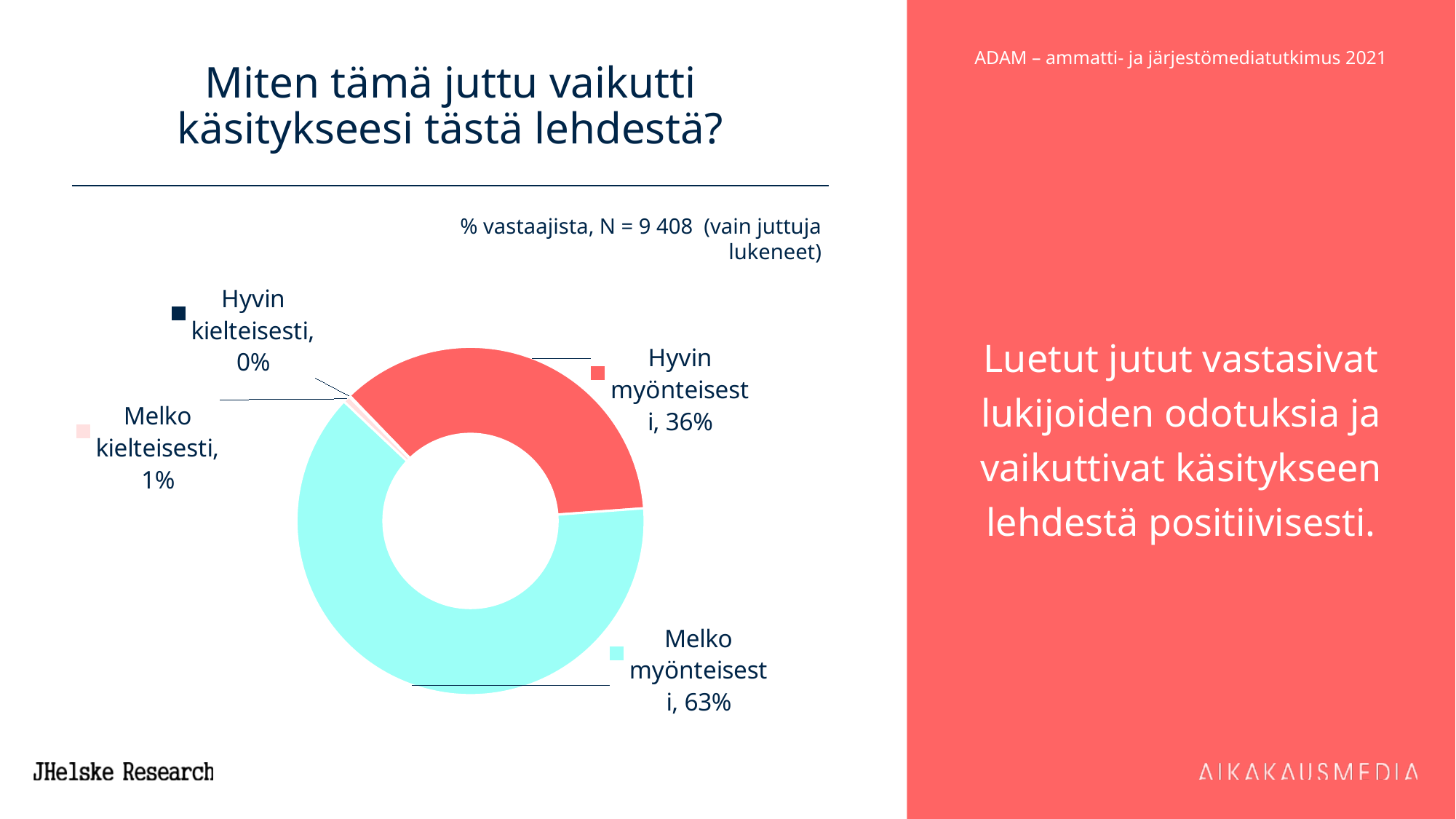
What kind of chart is shown on the slide? Doughnut chart What percentage of respondents answered "Hyvin myönteisesti"? 36% Which category has the smallest share of the chart? Hyvin kielteisesti Which category has the largest share of the chart? Melko myönteisesti What is the number of respondents (N) stated on the slide? 9 408 What is the combined share of the two positive categories ("Hyvin myönteisesti" and "Melko myönteisesti")? 99% What percentage of respondents answered "Hyvin kielteisesti"? 0% What percentage of respondents answered "Melko kielteisesti"? 1% Which is larger, the share for "Hyvin myönteisesti" or the share for "Melko kielteisesti"? Hyvin myönteisesti What percentage of respondents answered "Melko myönteisesti"? 63% What is the difference in percentage points between "Melko myönteisesti" and "Hyvin myönteisesti"? 27 How many categories are shown in the chart? 4